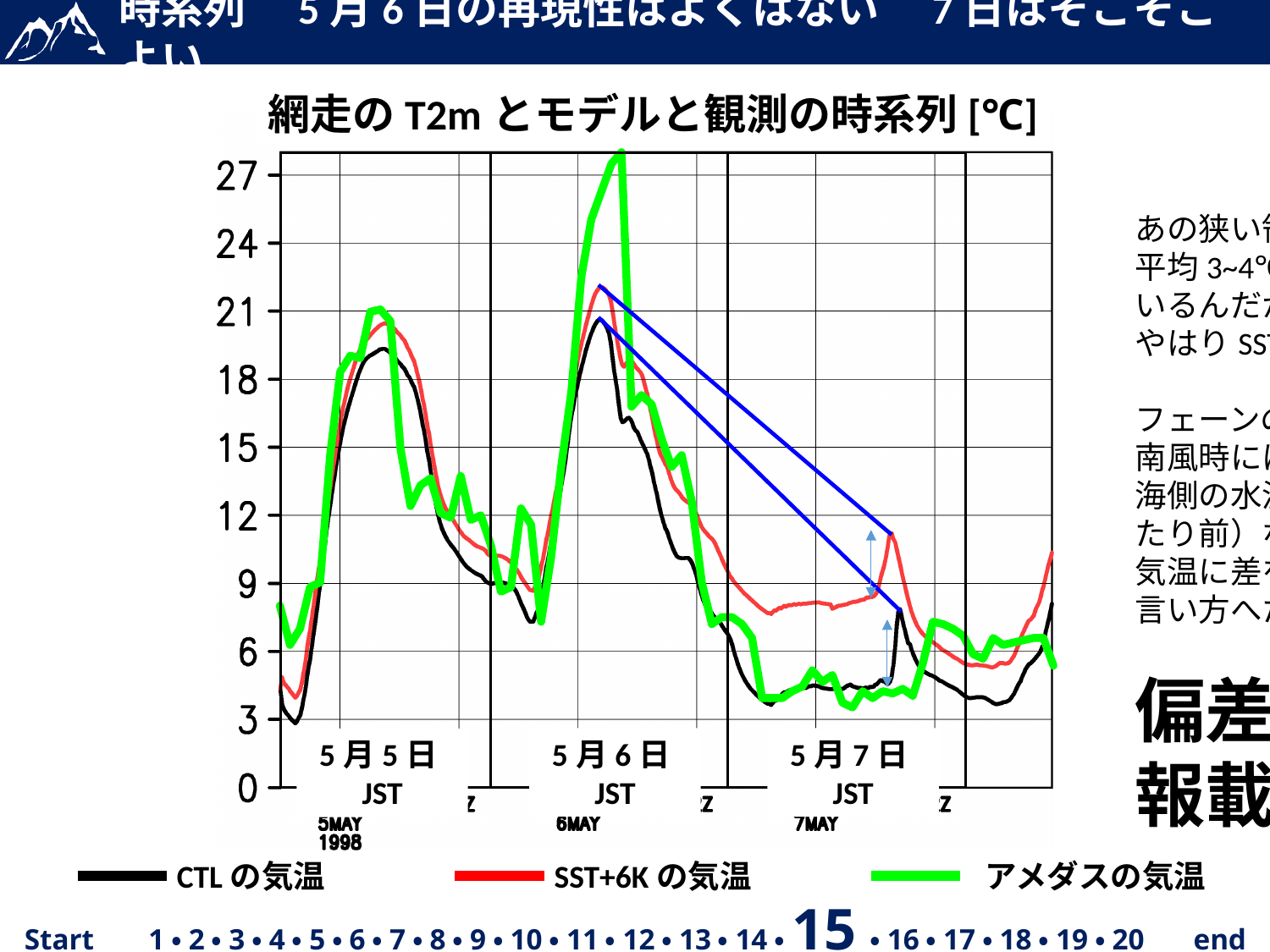
Is the lowest value of CTL の気温 on 5月7日 greater or less than 6? less What is the title of the chart? 網走の T2m とモデルと観測の時系列 [℃] Which colour represents アメダスの気温 in the chart? green What is the highest value shown on the y axis of the chart? 27 What kind of chart is shown on the slide? line chart Which series reaches the highest peak on 5月6日? アメダスの気温 During the middle of 5月7日, which series is higher: SST+6K の気温 or CTL の気温? SST+6K の気温 Is the peak value of アメダスの気温 on 5月5日 greater or less than 18? greater How many series does the legend list? 3 Is the value of CTL の気温 at the start of 5月5日 greater or less than 6? less How many dates are labelled along the x axis of the chart? 3